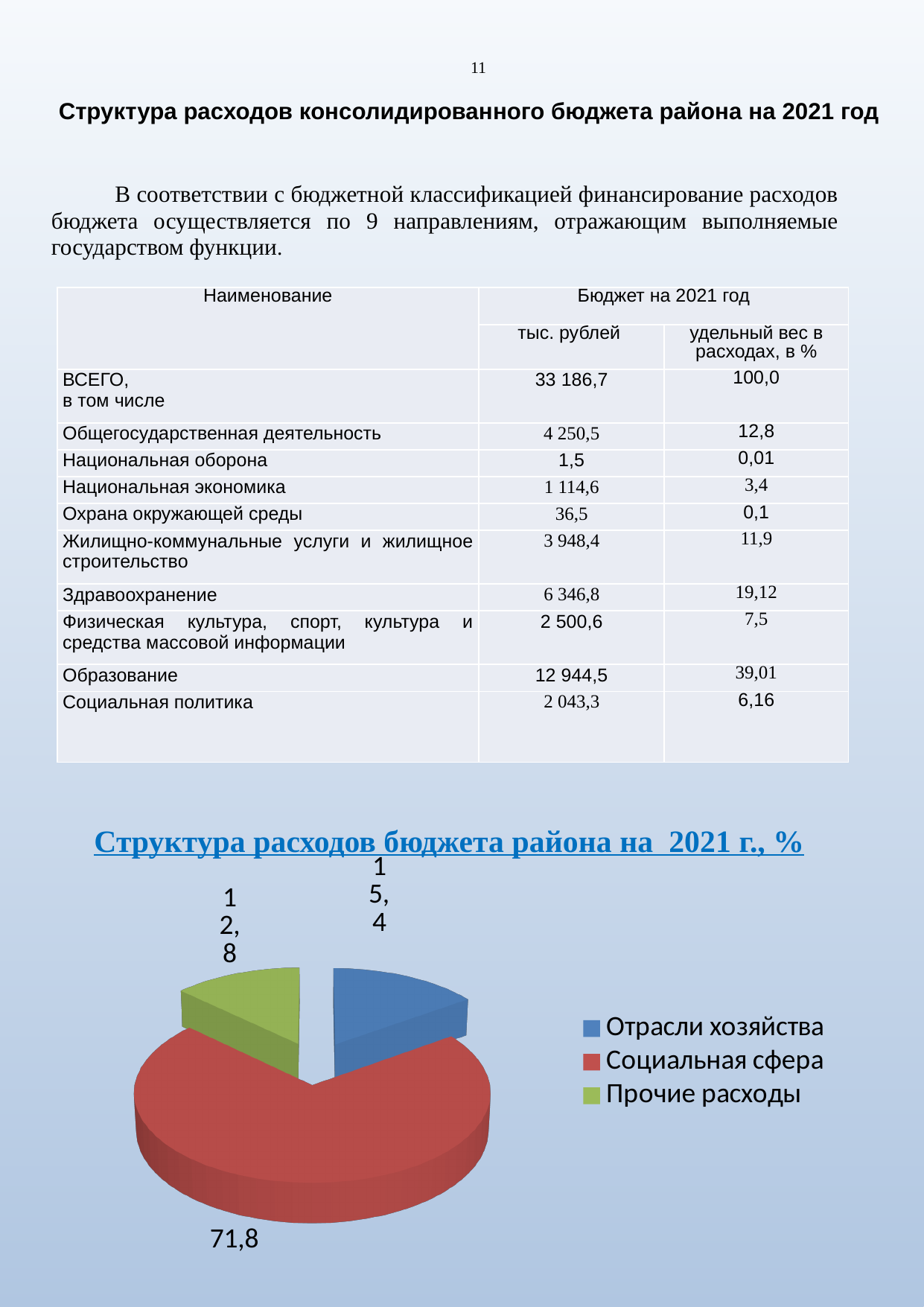
What is the value for Социальная сфера in the pie chart? 71,8 What is the value for Отрасли хозяйства in the pie chart? 15,4 Which colour represents Прочие расходы in the pie chart? green What kind of chart is shown on the slide? pie chart Which category has the smallest slice in the pie chart? Прочие расходы Which is larger in the pie chart, Отрасли хозяйства or Прочие расходы? Отрасли хозяйства How many slices does the pie chart have? 3 Which category has the largest slice in the pie chart? Социальная сфера How many entries does the legend of the pie chart list? 3 What is the title of the pie chart? Структура расходов бюджета района на 2021 г., % What is the difference between the values for Социальная сфера and Отрасли хозяйства in the pie chart? 56,4 What is the value for Прочие расходы in the pie chart? 12,8